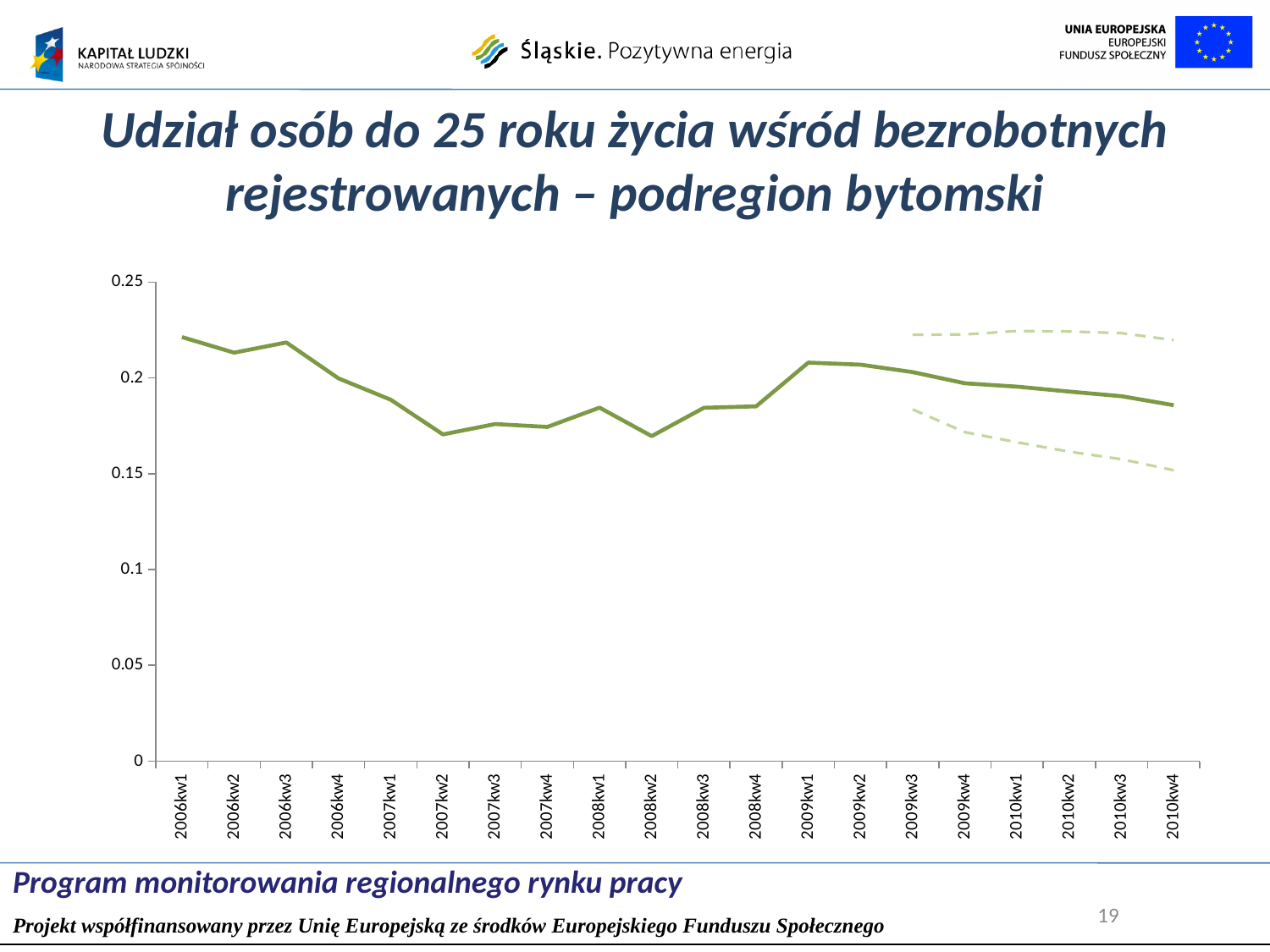
What kind of chart is shown on the slide? line chart Which is larger, the value for 2006kw1 or the value for 2007kw2? 2006kw1 Is the value for 2009kw1 greater or less than 0.2? greater Does the solid line rise or fall from 2009kw1 to 2010kw4? fall Is the value for 2007kw2 greater or less than 0.2? less Is the value for 2008kw2 greater or less than 0.15? greater How many quarters are shown on the x axis of the chart? 20 At which quarter do the dashed lines on the chart begin? 2009kw3 Which is larger, the value for 2008kw2 or the value for 2009kw1? 2009kw1 Does the solid line rise or fall from 2008kw2 to 2009kw1? rise